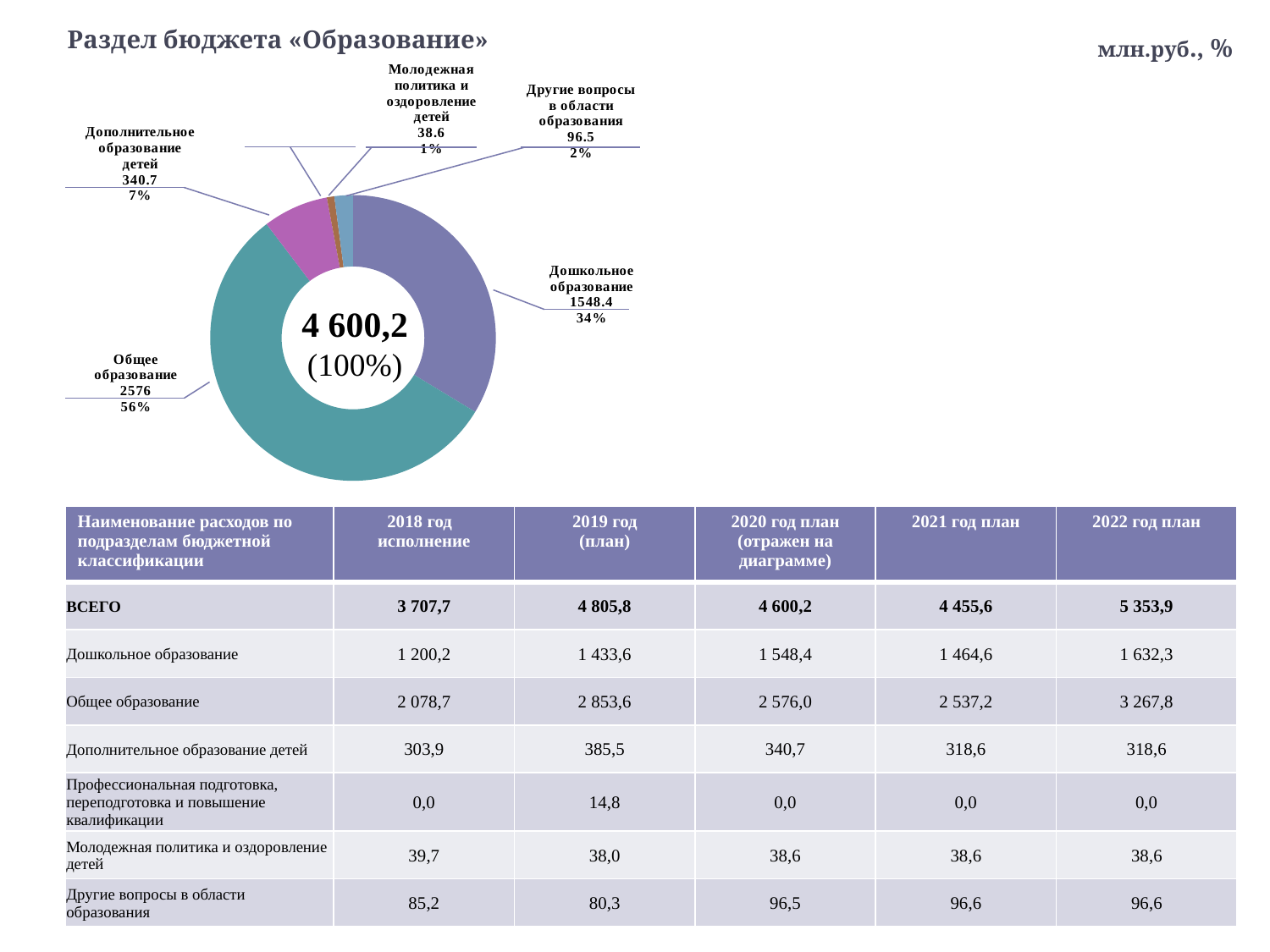
What value is shown for Молодежная политика и оздоровление детей on the chart? 38.6 What share of the chart does Общее образование represent? 56% What total value is shown in the centre of the chart? 4 600,2 What value is shown for Дошкольное образование on the chart? 1548.4 How many labelled categories does the chart show? 5 What value is shown for Дополнительное образование детей on the chart? 340.7 What is the difference between the values for Общее образование and Дошкольное образование on the chart? 1027.6 What value is shown for Общее образование on the chart? 2576 What kind of chart is shown on the slide? Doughnut (pie) chart Which category has the smallest slice in the chart? Молодежная политика и оздоровление детей What share of the chart does Другие вопросы в области образования represent? 2% Which category has the largest slice in the chart? Общее образование